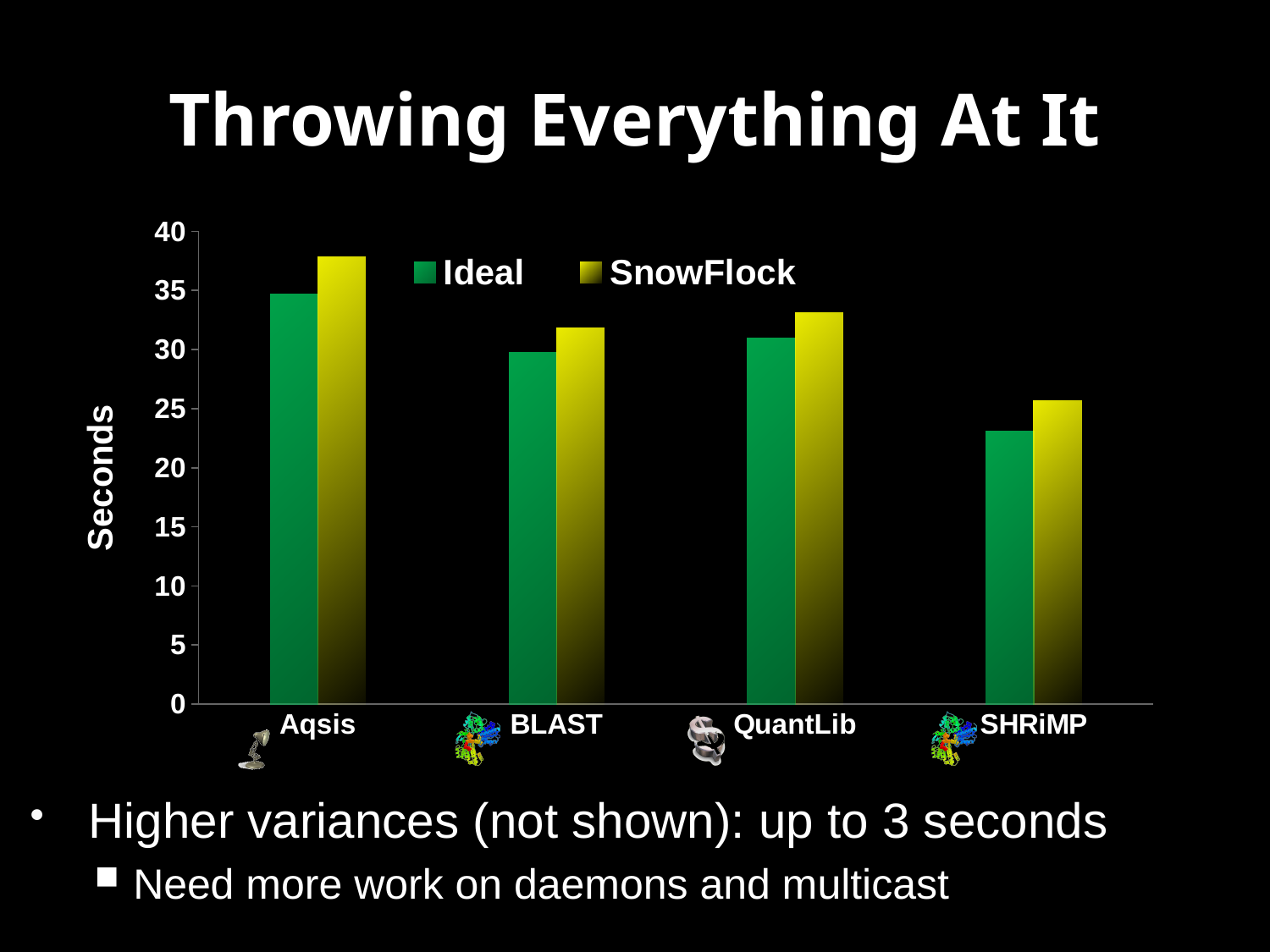
Is the SnowFlock value for Aqsis greater or less than 35? greater How many series does the chart's legend list? 2 What is the label on the vertical axis of the chart? Seconds Is the Ideal value for BLAST greater or less than 25? greater What kind of chart is shown on the slide? bar chart Which category has the lowest Ideal value? SHRiMP For Aqsis, which is larger: the Ideal value or the SnowFlock value? SnowFlock What are the two series named in the chart's legend? Ideal and SnowFlock Which category has the lowest SnowFlock value? SHRiMP How many categories are shown along the x axis of the chart? 4 Which category has the highest SnowFlock value? Aqsis Is the Ideal value for SHRiMP greater or less than 25? less